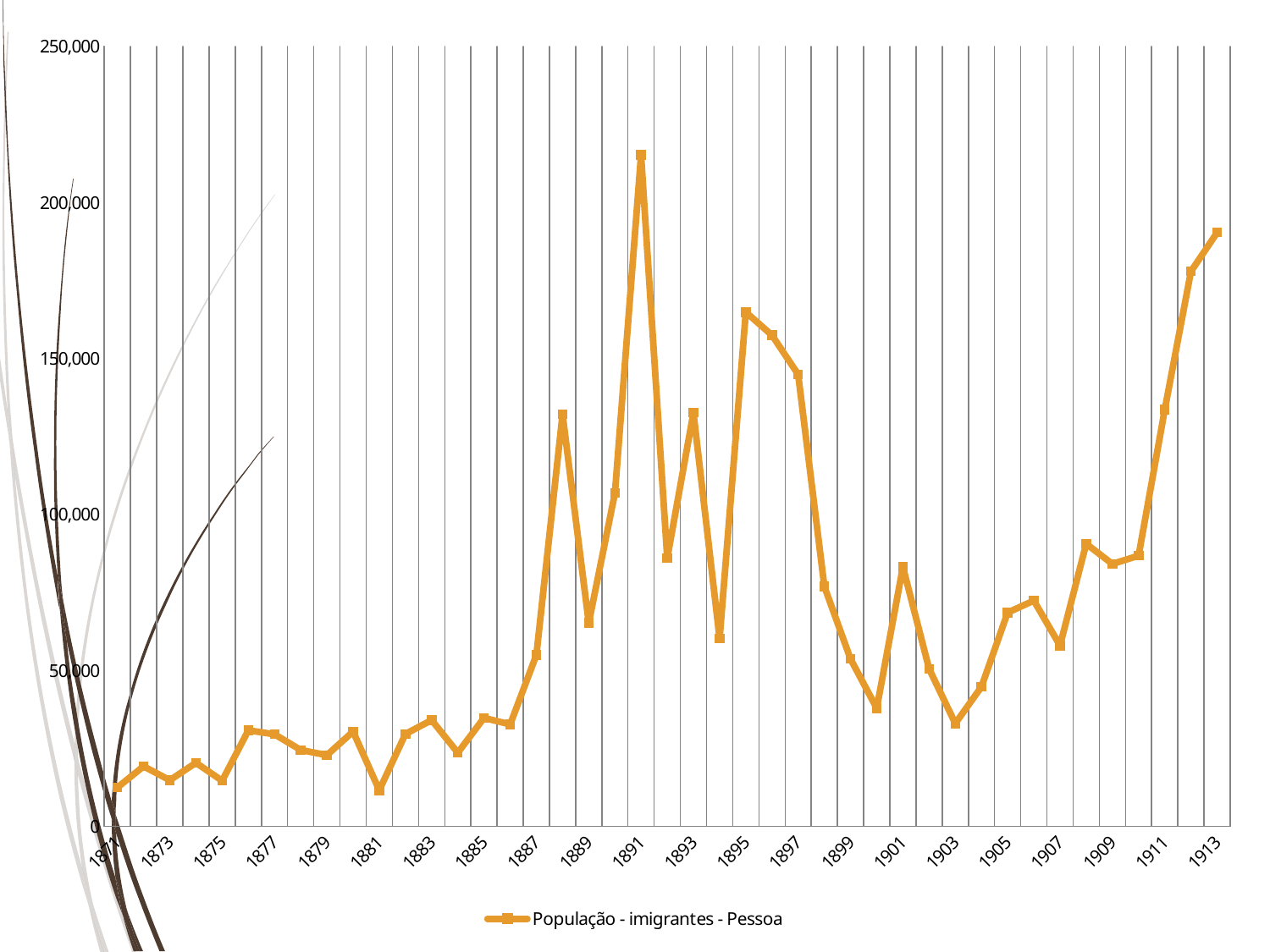
Is the value for 1891 greater or less than 200,000? greater Do the values rise or fall from 1895 to 1900? fall In which year does the series reach its highest value? 1891 Which year has the larger value, 1891 or 1895? 1891 Is the value for 1913 greater or less than 150,000? greater How many series does the legend list? 1 Is the value for 1881 greater or less than 50,000? less Which year has the larger value, 1888 or 1889? 1888 What kind of chart is shown on the slide? line chart What is the name of the series shown in the legend? População - imigrantes - Pessoa Do the values rise or fall from 1909 to 1913? rise